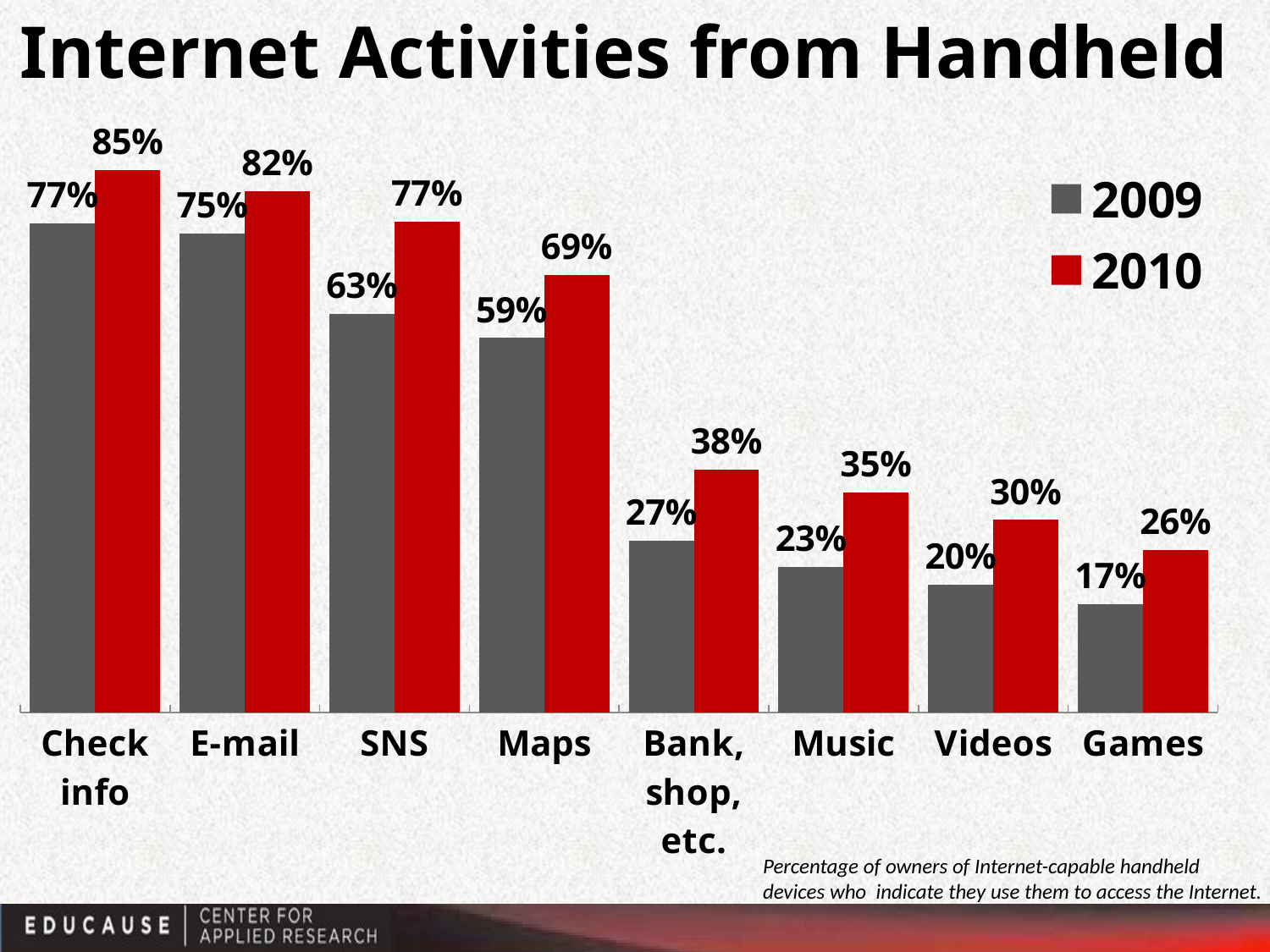
Which category has the lowest 2009 value? Games How many series does the legend list? 2 Which category has the highest 2010 value? Check info What is the 2009 value for Maps? 59% What is the difference between the 2010 and 2009 values for Games? 9% Which colour represents the 2010 series? Red What is the difference between the 2010 and 2009 values for SNS? 14% What kind of chart is shown on the slide? Bar chart How many categories are shown on the x axis? 8 Which is larger, the 2009 value for Music or the 2009 value for Videos? Music What is the 2010 value for Check info? 85% What is the 2010 value for Bank, shop, etc.? 38%